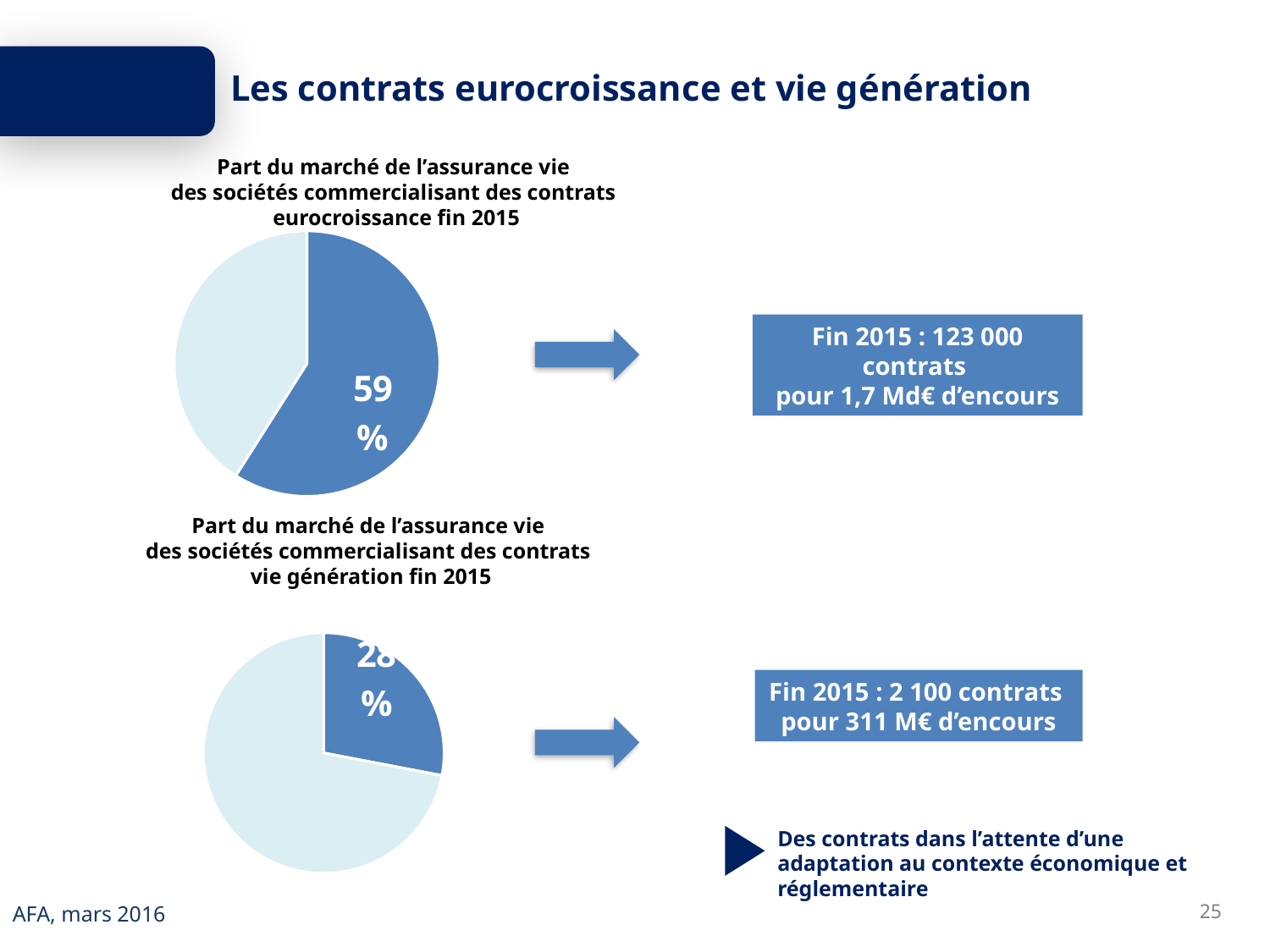
How many slices does the bottom pie chart (vie génération) have? 2 How many pie charts are shown on the slide? 2 What is the title of the top pie chart? Part du marché de l'assurance vie des sociétés commercialisant des contrats eurocroissance fin 2015 What is the difference between the labelled share in the eurocroissance pie chart (59%) and the labelled share in the vie génération pie chart (28%)? 31 percentage points In the bottom pie chart (vie génération fin 2015), what share of the life insurance market is held by companies selling vie génération contracts? 28% How many slices does the top pie chart (eurocroissance) have? 2 What colour is the slice labelled 28% in the bottom pie chart? Dark blue In the bottom pie chart, is the dark blue slice (28%) larger or smaller than the light blue slice? Smaller Which is larger: the labelled share in the eurocroissance pie chart or the labelled share in the vie génération pie chart? Eurocroissance (59%) In the top pie chart (eurocroissance fin 2015), what share of the life insurance market is held by companies selling eurocroissance contracts? 59% What type of chart is used on this slide for the eurocroissance market share? Pie chart In the top pie chart, is the dark blue slice (59%) larger or smaller than the light blue slice? Larger